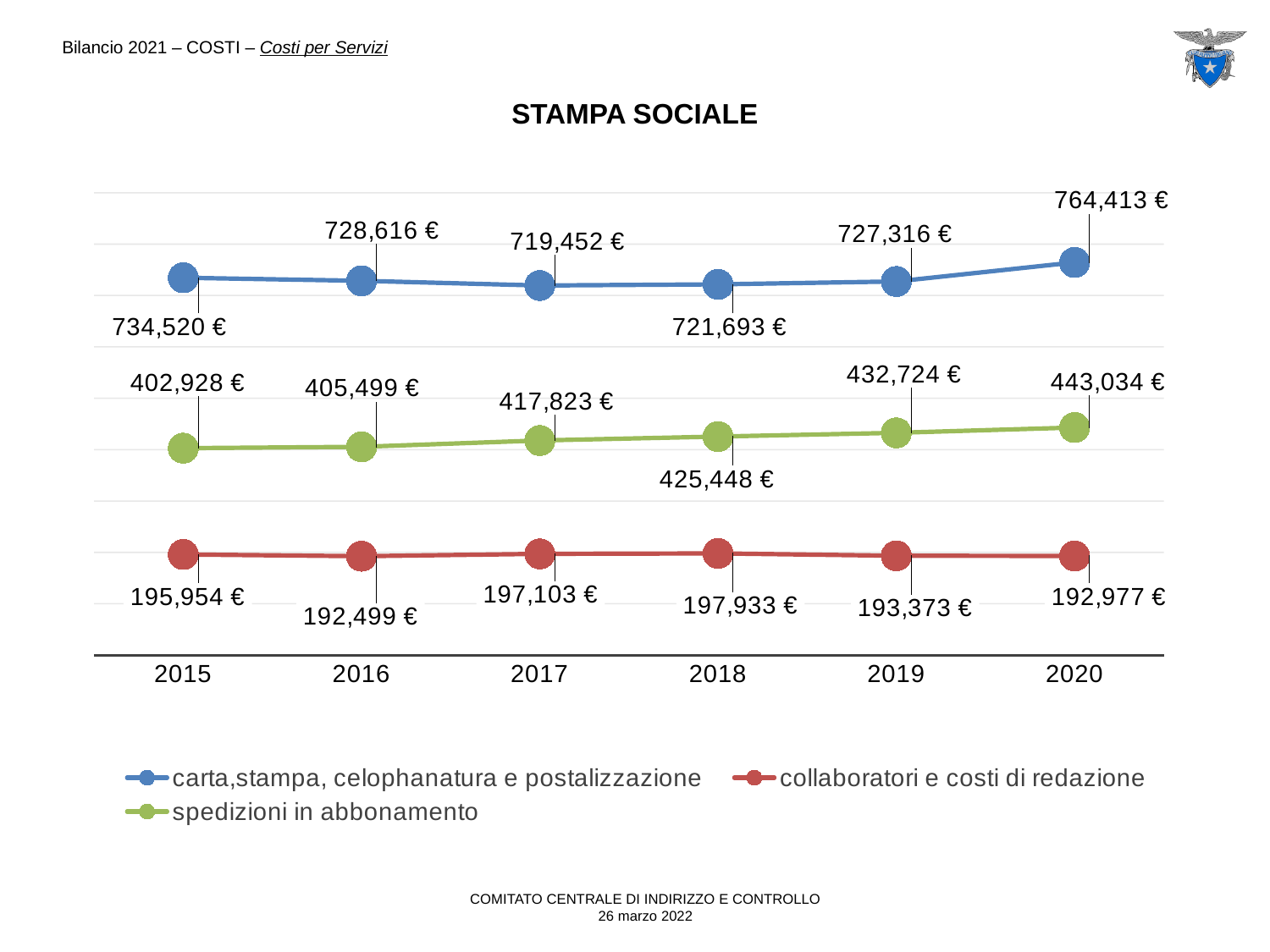
What type of chart is shown on the slide? Line chart What is the value for 'carta,stampa, celophanatura e postalizzazione' in 2020? 764,413 € In which year is 'spedizioni in abbonamento' at its highest? 2020 What is the value for 'collaboratori e costi di redazione' in 2016? 192,499 € What is the title of the chart? STAMPA SOCIALE Do the values for 'spedizioni in abbonamento' rise or fall from 2015 to 2020? Rise Which is larger for 'collaboratori e costi di redazione': the 2018 value or the 2019 value? 2018 How many years are shown on the x axis? 6 What is the difference between the 2020 and 2019 values for 'carta,stampa, celophanatura e postalizzazione'? 37,097 € How many series does the legend list? 3 In which year is 'carta,stampa, celophanatura e postalizzazione' at its lowest? 2017 What is the value for 'spedizioni in abbonamento' in 2017? 417,823 €